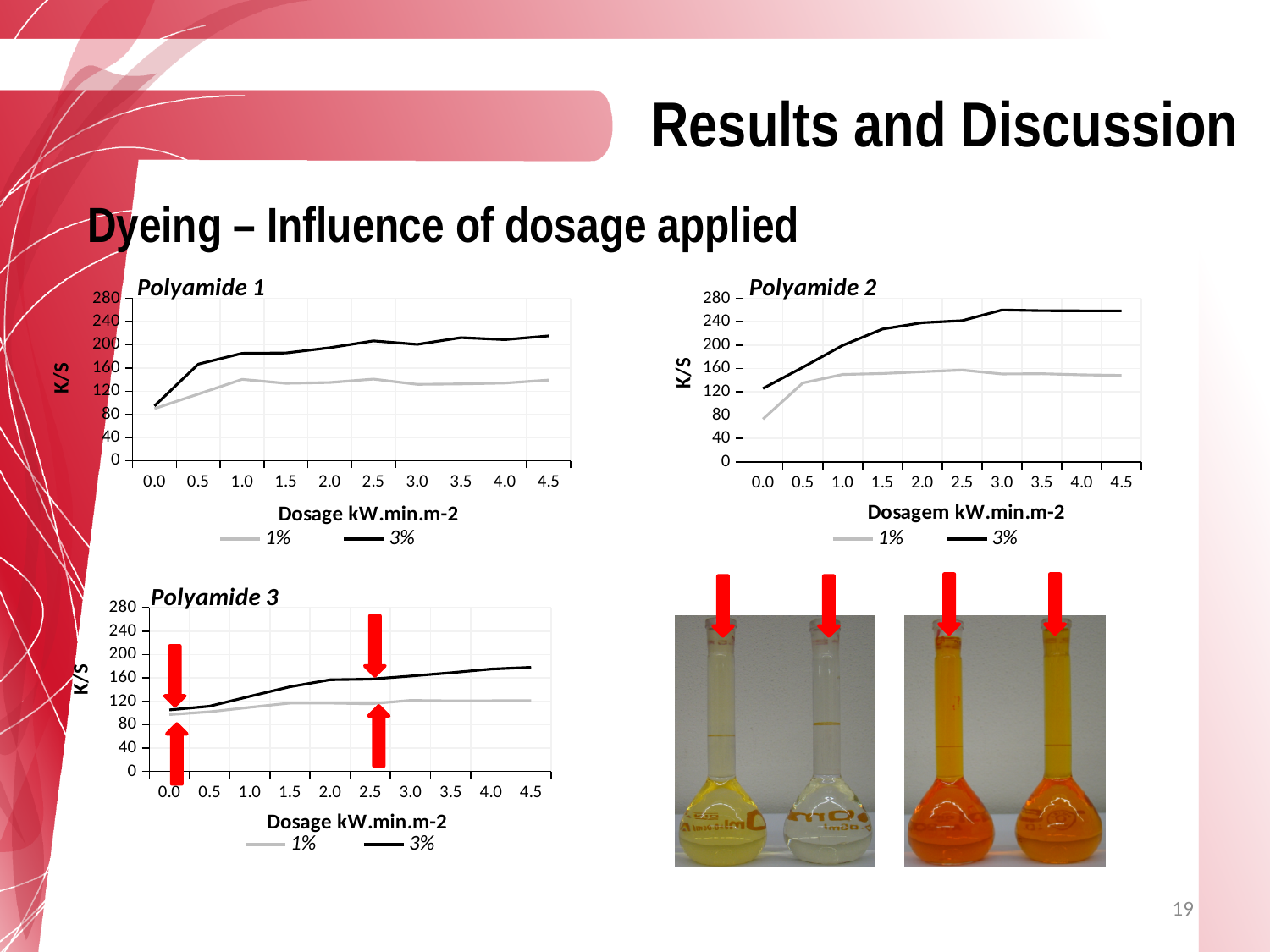
In the Polyamide 3 chart, is the value of the 1% series at dosage 0.0 greater or less than 120? less In the Polyamide 2 chart, is the value of the 3% series at dosage 3.0 greater or less than 240? greater In the Polyamide 3 chart, does the 3% series generally rise or fall as dosage increases from 0.0 to 4.5? rise In the Polyamide 2 chart, which series has the larger value at dosage 4.5, 1% or 3%? 3% In the Polyamide 3 chart, is the value of the 3% series at dosage 4.5 greater or less than 160? greater How many series does the legend of the Polyamide 2 chart list? 2 How many dosage values are marked on the x axis of the Polyamide 1 chart? 10 What is the x-axis title of the Polyamide 2 chart? Dosagem kW.min.m-2 What kind of chart is the Polyamide 1 chart? line chart